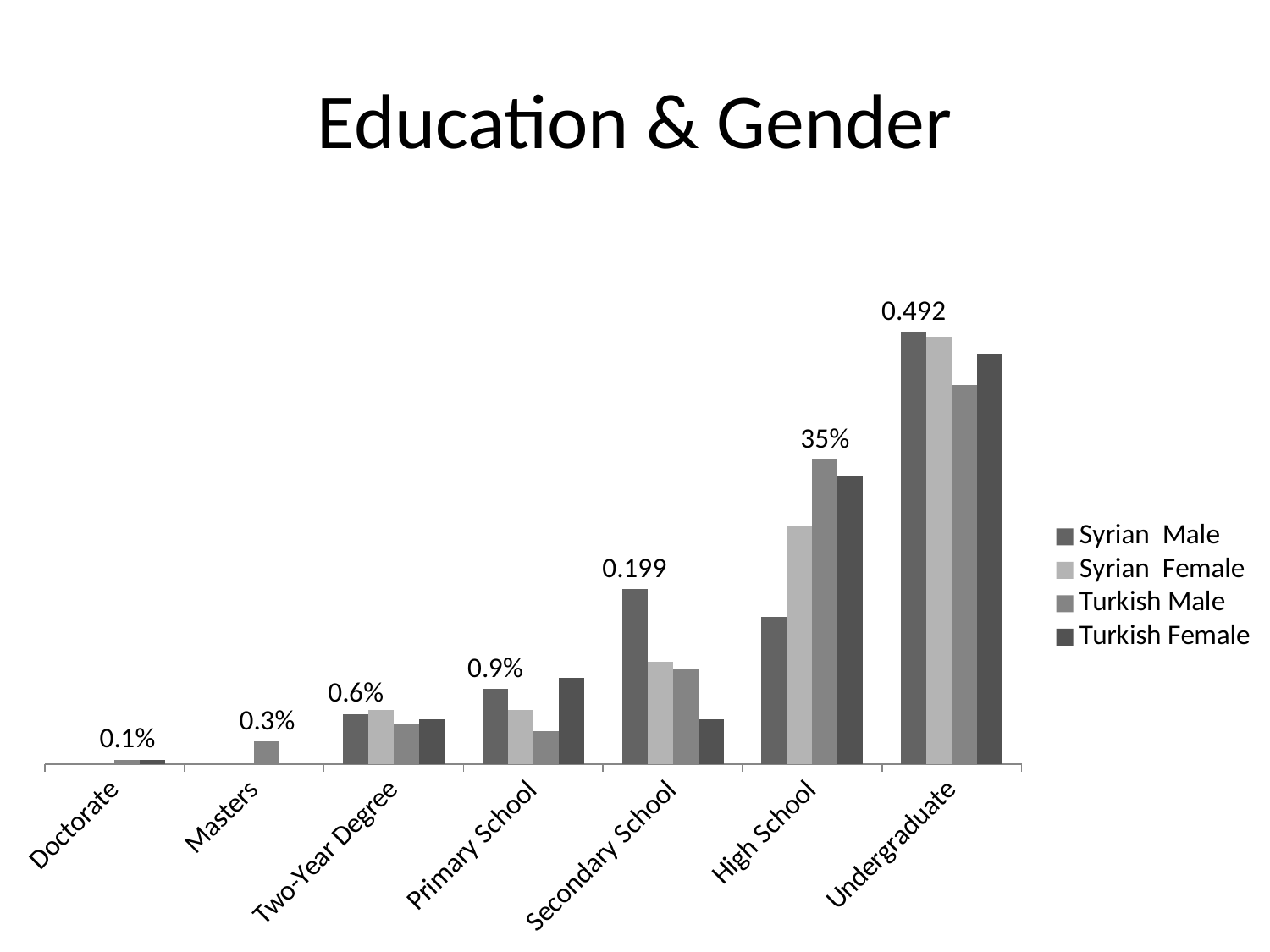
What is the title of the chart? Education & Gender What data label is shown above the High School group? 35% What data label is shown above the Secondary School group? 0.199 What data label is shown above the Undergraduate group? 0.492 What kind of chart is shown on the slide? bar chart Which education category has the shortest bars overall? Doctorate How many education categories are shown on the x axis? 7 In the High School group, which series has the tallest bar? Turkish Male In the Undergraduate group, is the Syrian Male bar or the Turkish Male bar taller? Syrian Male Which education category has the tallest bars overall? Undergraduate How many series does the legend list? 4 What data label is shown above the Doctorate group? 0.1%